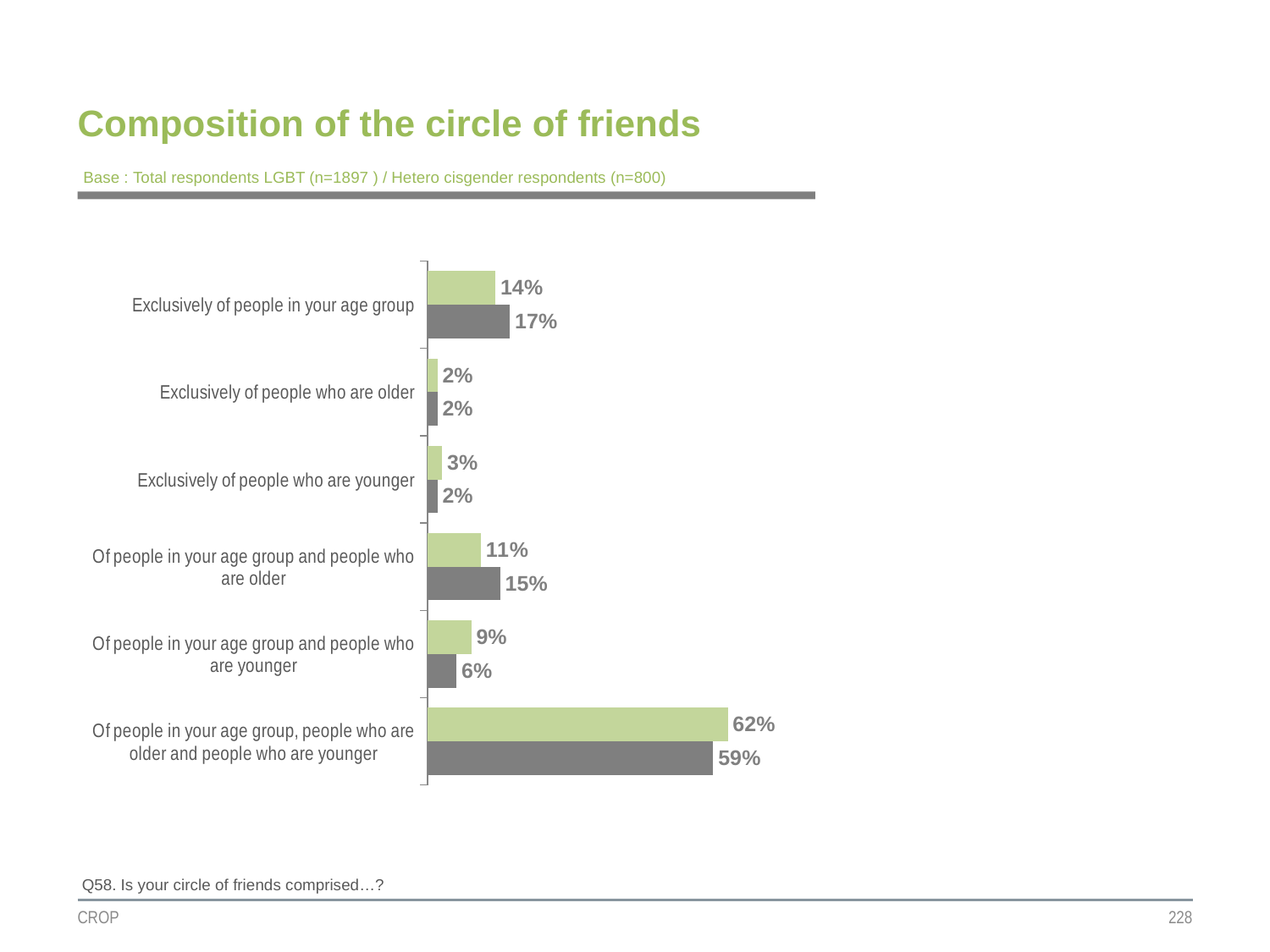
What is the value of the green bar for "Of people in your age group and people who are younger"? 9% Which category has the highest green bar value? Of people in your age group, people who are older and people who are younger What is the value of the green bar for "Exclusively of people in your age group"? 14% What is the title of the chart on the slide? Composition of the circle of friends What is the value of the grey bar for "Of people in your age group and people who are older"? 15% What is the difference between the green and grey bars for "Of people in your age group, people who are older and people who are younger"? 3% What is the value of the grey bar for "Exclusively of people in your age group"? 17% What is the difference between the grey bar values for "Exclusively of people in your age group" and "Of people in your age group and people who are younger"? 11% For "Of people in your age group and people who are older", which is larger, the green bar or the grey bar? the grey bar What kind of chart is shown on the slide? bar chart Which category has the lowest grey bar value? Exclusively of people who are older and Exclusively of people who are younger (both 2%) How many categories are shown on the chart? 6